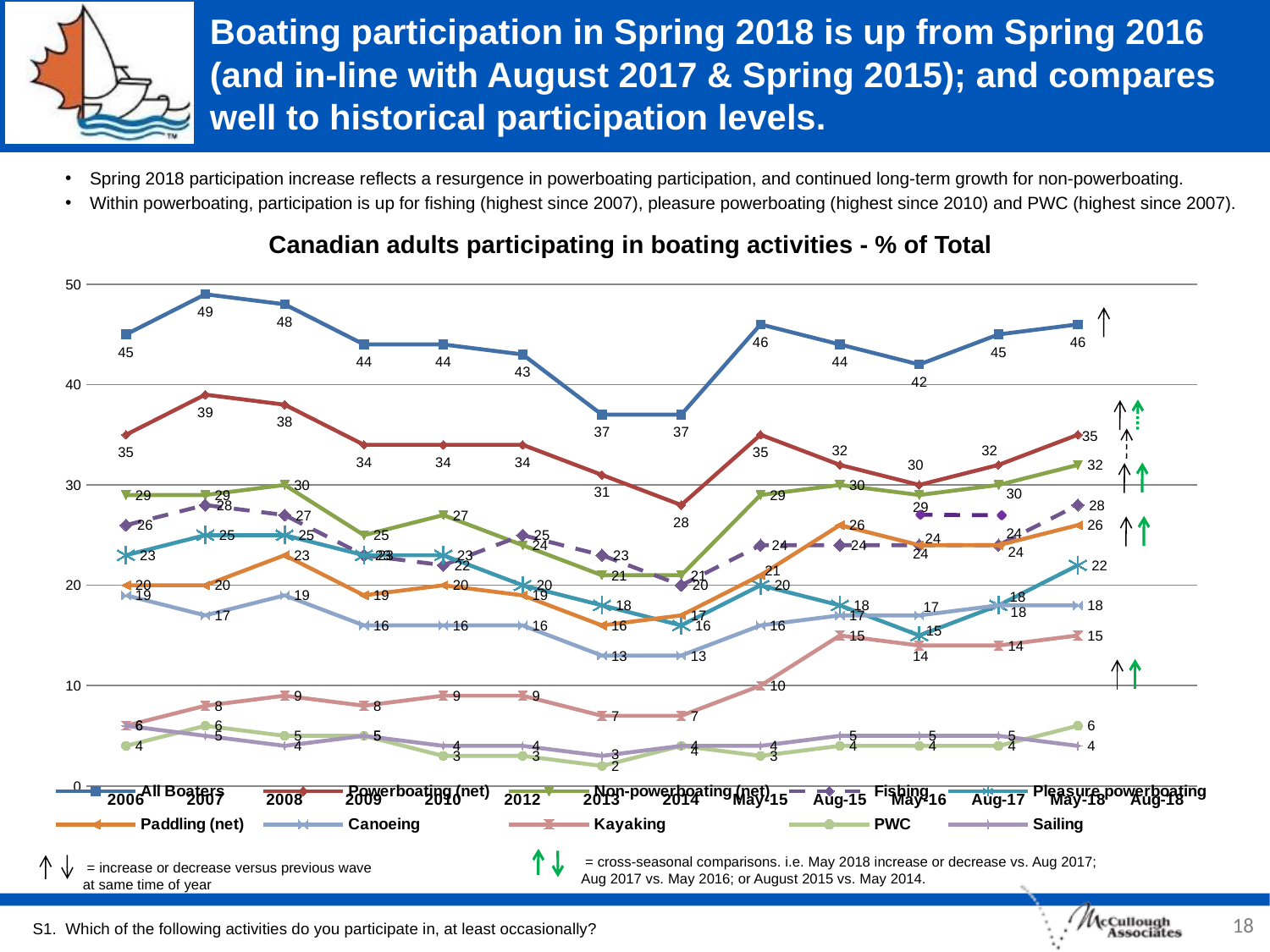
What kind of chart is shown on the slide? Line chart In which period is the Powerboating (net) value lowest? 2014 In which year does the All Boaters series reach its highest value? 2007 Does the All Boaters series rise or fall from 2007 to 2013? Fall Is the All Boaters value for 2008 greater or less than 40? greater What is the Canoeing value for 2013? 13 What is the All Boaters value for 2007? 49 What is the title of the chart? Canadian adults participating in boating activities - % of Total How many series does the chart legend list? 10 What is the Kayaking value for Aug-15? 15 In 2006, which is larger: Powerboating (net) or Non-powerboating (net)? Powerboating (net) What is the difference between the All Boaters value in May-18 and in May-16? 4